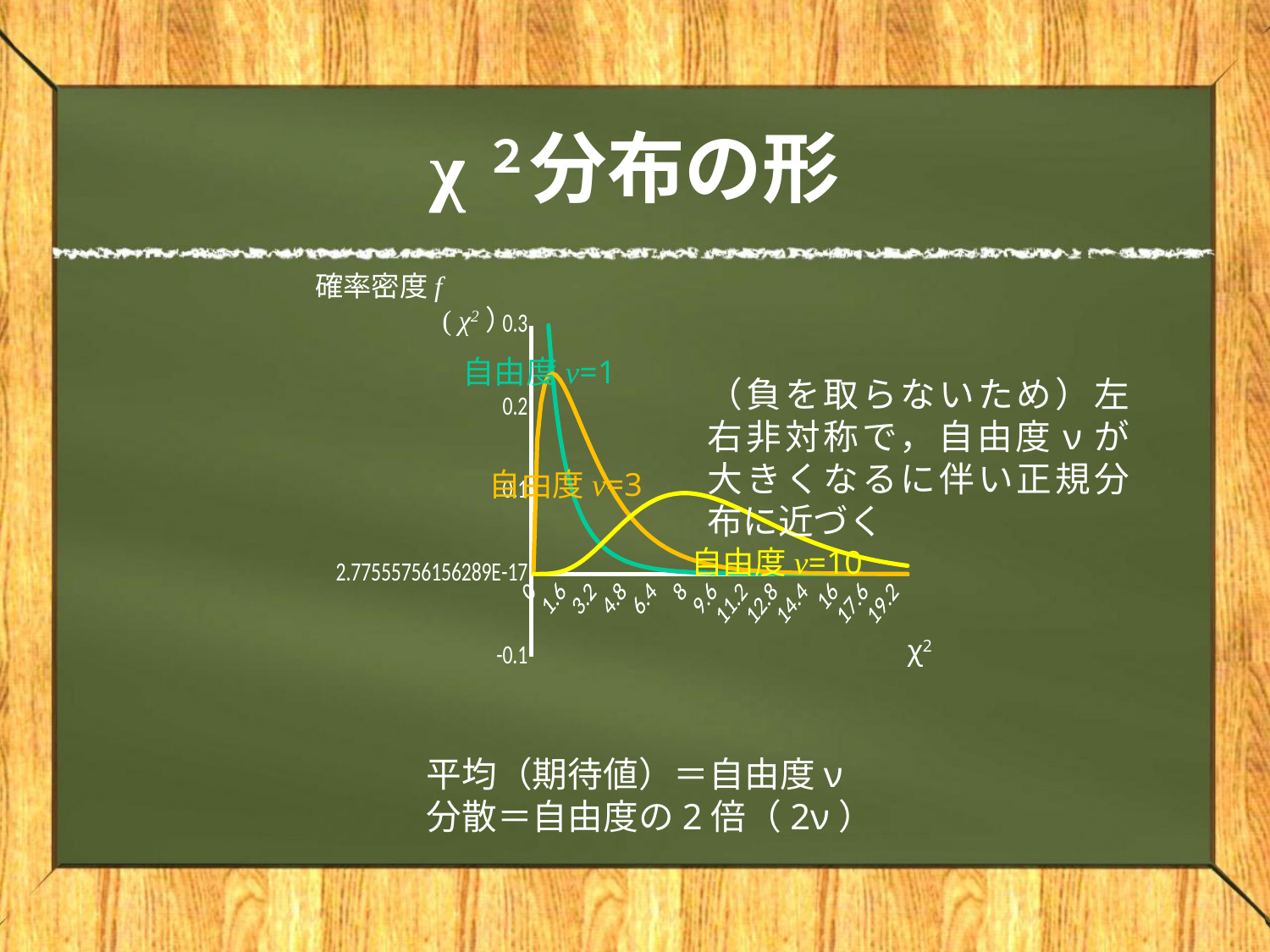
Is the value of the 自由度 ν=10 curve at χ²=0 greater or less than 0.1? less What kind of chart is shown on the slide? line chart Does the curve for 自由度 ν=1 rise or fall as χ² increases along the x axis? fall How many curves (degrees of freedom ν) are plotted on the chart? 3 Is the peak of the curve for 自由度 ν=3 greater or less than 0.2? greater Which degrees of freedom value is labelled on the green curve? ν=1 What is the largest tick label shown on the χ² axis? 19.2 What colour is the curve labelled 自由度 ν=10? yellow Which curve has the lowest peak value? 自由度 ν=10 Which curve is higher at χ²=8, 自由度 ν=1 or 自由度 ν=10? 自由度 ν=10 Which curve has its peak furthest to the right along the χ² axis? 自由度 ν=10 Is the peak of the curve for 自由度 ν=10 greater or less than 0.2? less